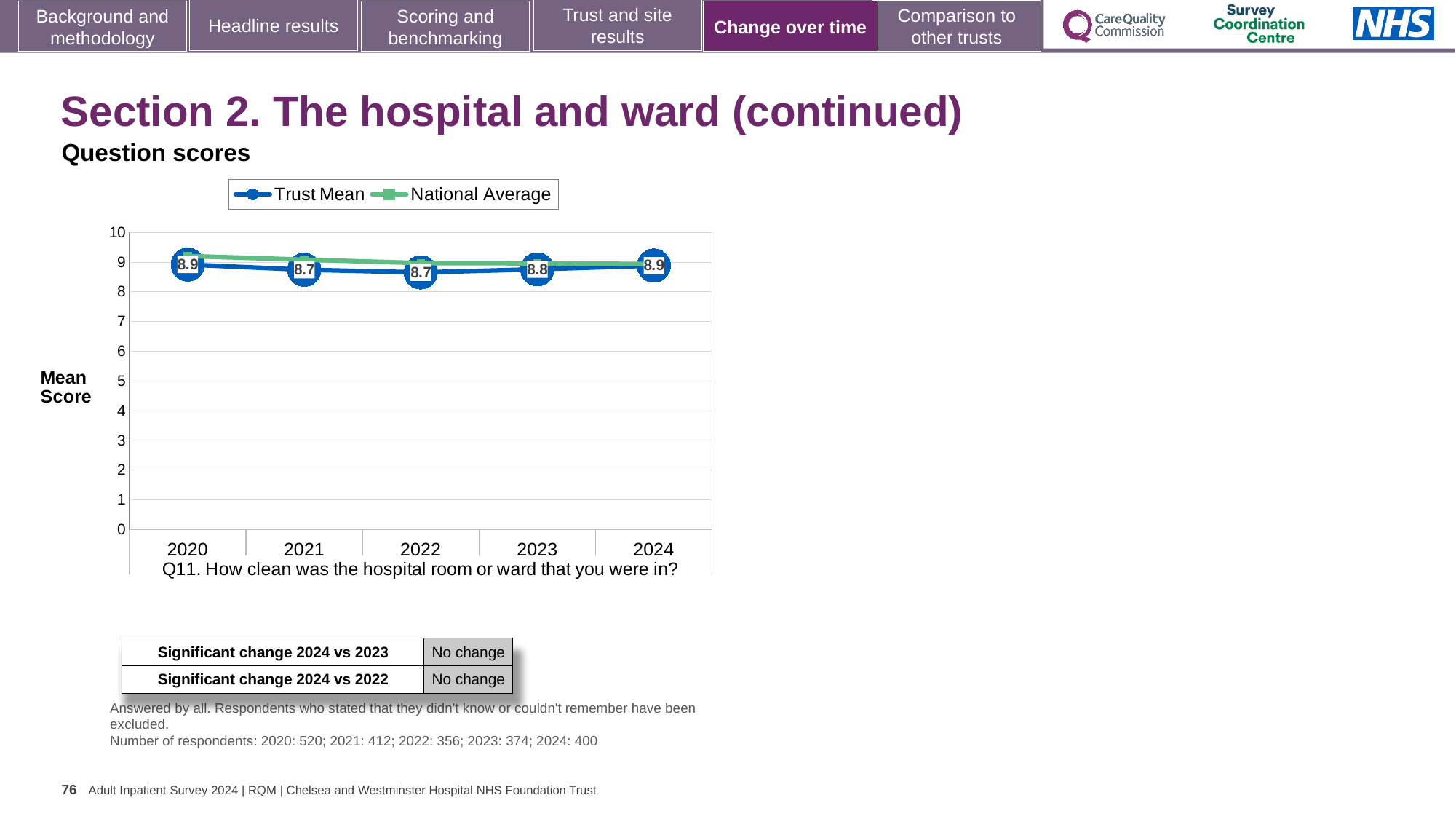
How many series does the chart legend list? 2 What is the Trust Mean value for 2021? 8.7 How many years are shown on the x axis of the chart? 5 What is the Trust Mean value for 2023? 8.8 Which year has the larger Trust Mean value, 2021 or 2023? 2023 Is the National Average value for 2020 greater or less than 8? greater What is the Trust Mean value for 2024? 8.9 What is the Trust Mean value for 2020? 8.9 Does the Trust Mean rise or fall from 2022 to 2024? Rise What is the difference between the Trust Mean values for 2020 and 2021? 0.2 Is the Trust Mean value for 2022 greater or less than 5? greater What kind of chart is shown on the slide? Line chart